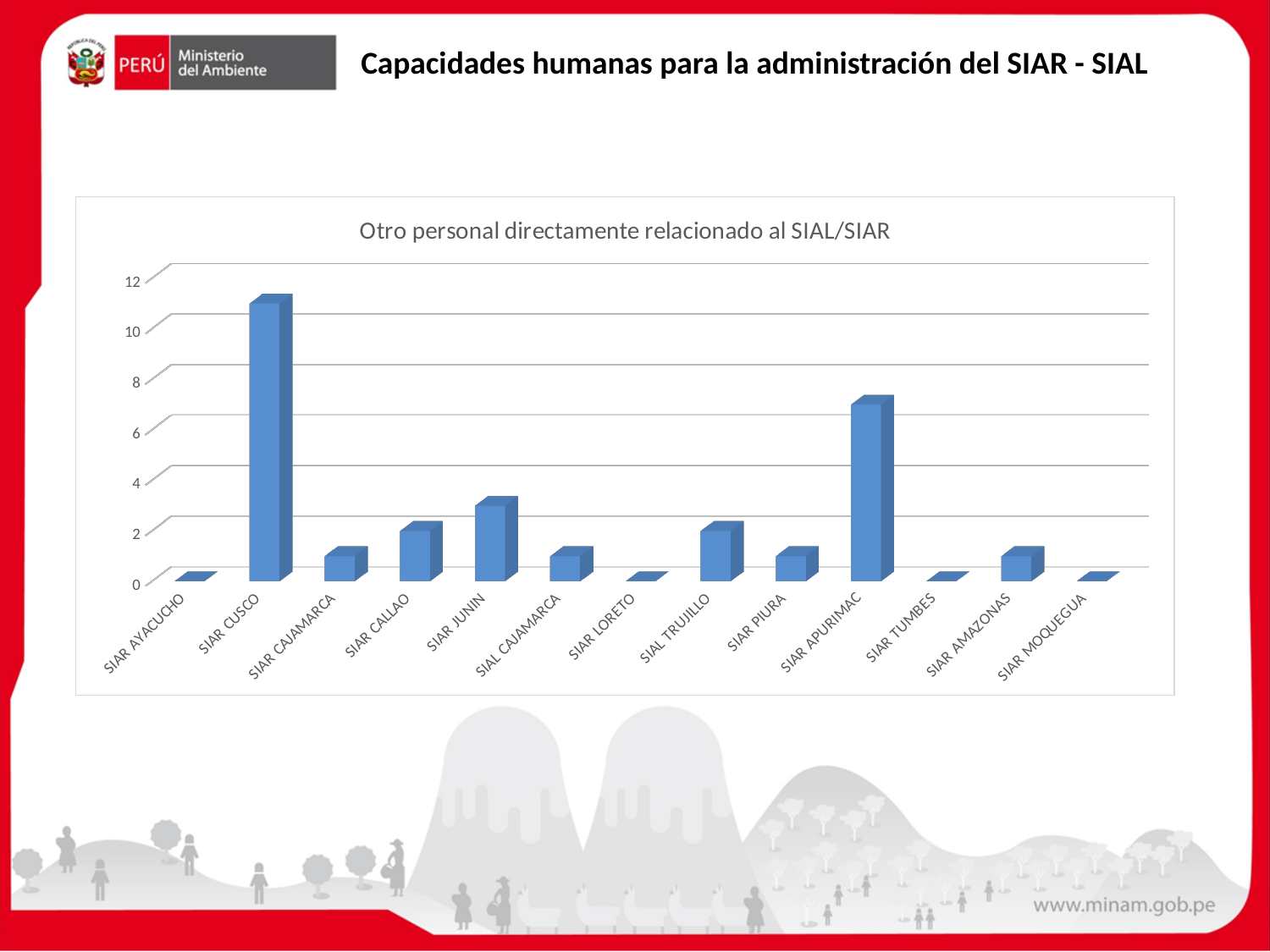
Which has a larger value, SIAR APURIMAC or SIAL TRUJILLO? SIAR APURIMAC Is the value for SIAR APURIMAC greater or less than 8? less Is the value for SIAR APURIMAC greater or less than 6? greater Is the value for SIAR CUSCO greater or less than 10? greater Which category has the highest value in the chart? SIAR CUSCO Which has a larger value, SIAR JUNIN or SIAR CALLAO? SIAR JUNIN What kind of chart is shown on the slide? bar chart How many categories are shown on the x axis of the chart? 13 Which has a larger value, SIAR CUSCO or SIAR APURIMAC? SIAR CUSCO What is the title of the chart? Otro personal directamente relacionado al SIAL/SIAR